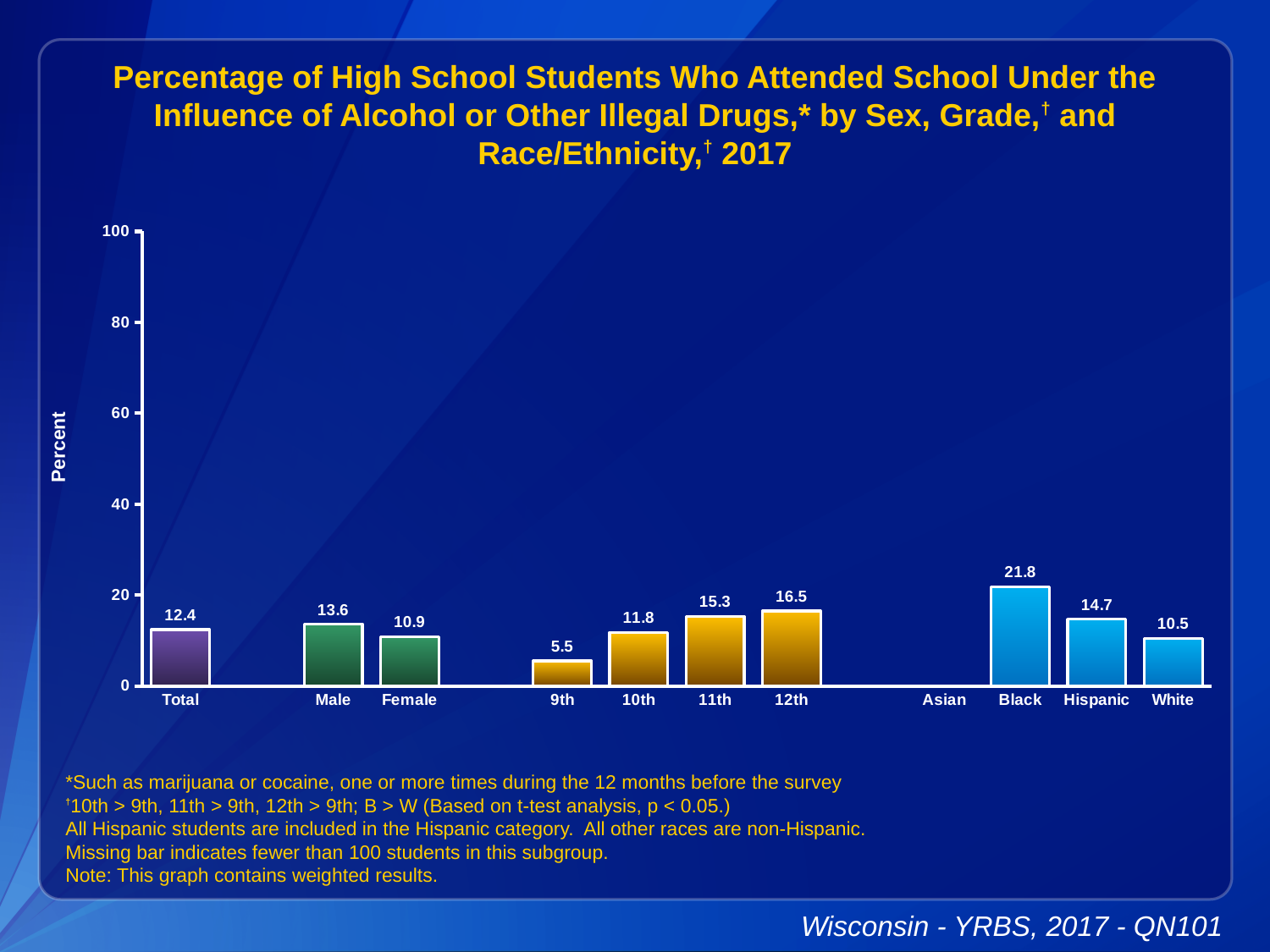
What is the difference between the Male and Female values? 2.7 Do the values rise or fall from 9th grade to 12th grade? rise What is the value for Black students? 21.8 Which category has the highest value? Black Which category has the lowest value among the bars shown? 9th Is the value for Black students greater or less than 20? greater What is the value for Male? 13.6 Which category on the x axis has no bar shown? Asian What kind of chart is shown? bar chart What is the value for 9th grade? 5.5 Which is larger, the value for 11th grade or 12th grade? 12th What is the value for Total? 12.4